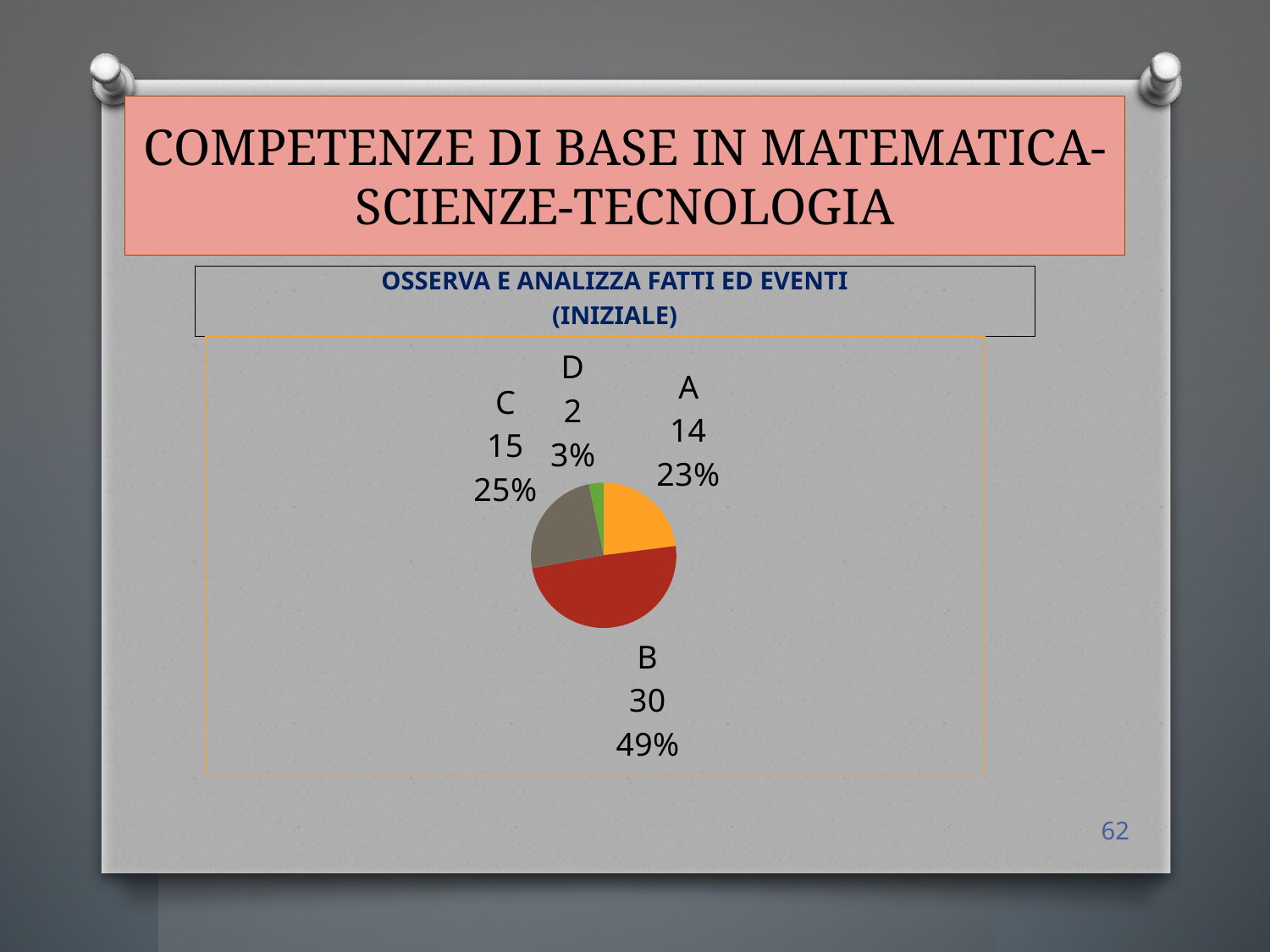
What kind of chart is shown on the slide? pie chart How many categories are shown in the pie chart? 4 What percentage share of the pie does category D have? 3% Which category has the smallest slice? D What percentage share of the pie does category B have? 49% What is the value for category B? 30 What is the value for category A? 14 What is the difference between the values for B and C? 15 What is the title of the chart? OSSERVA E ANALIZZA FATTI ED EVENTI (INIZIALE) What is the value for category D? 2 What is the value for category C? 15 Which category has the largest slice? B